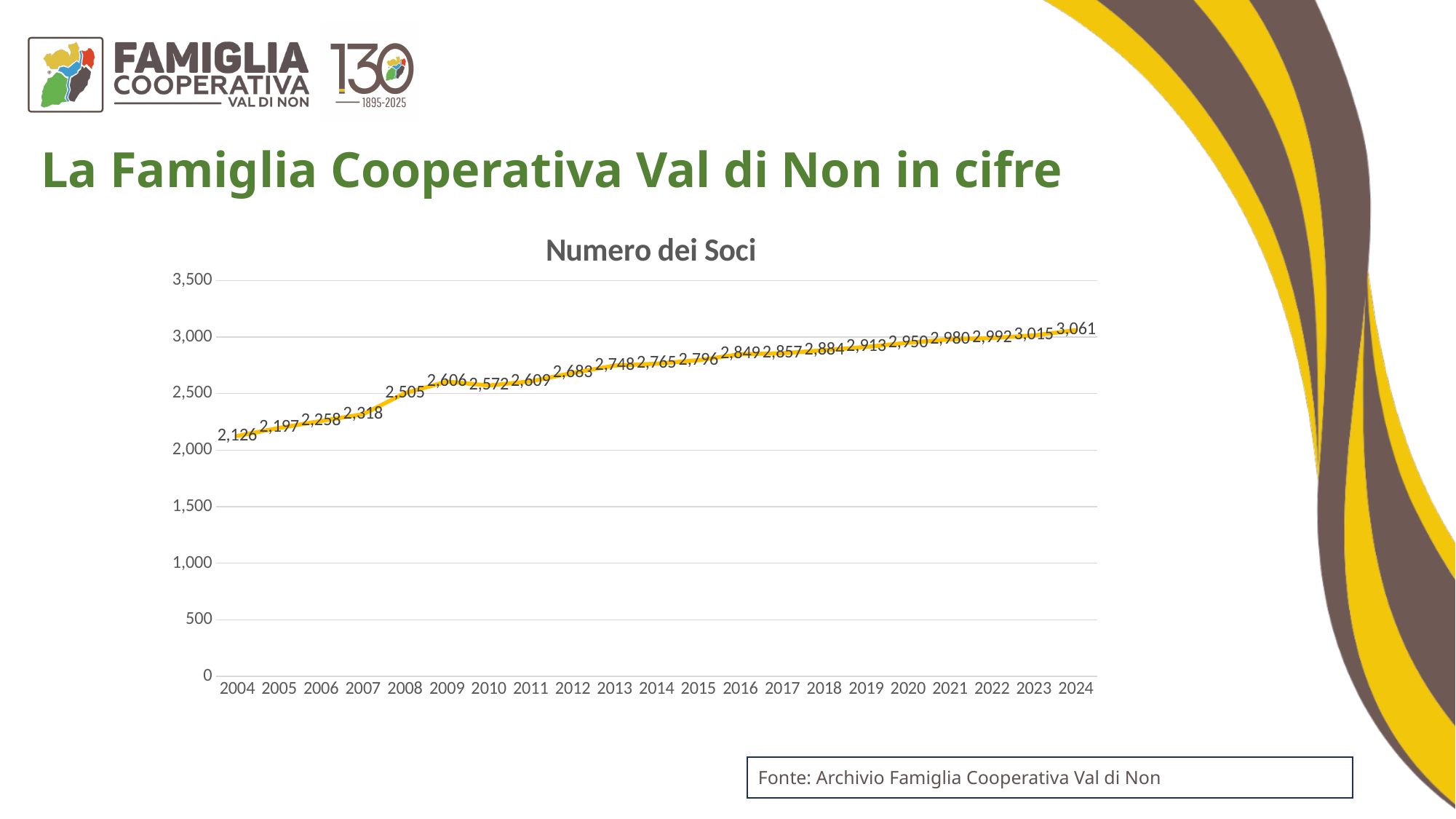
Which year has the lowest value? 2004 Which is larger, the value for 2009 or the value for 2010? 2009 What is the difference between the values for 2008 and 2007? 187 Which year has the highest value? 2024 What is the value for 2024? 3,061 What is the value for 2004? 2,126 What is the title of the chart? Numero dei Soci What is the difference between the values for 2024 and 2004? 935 How many years are plotted on the x axis? 21 What type of chart is shown on the slide? Line chart Do the values generally rise or fall from 2004 to 2024? Rise What is the value for 2008? 2,505